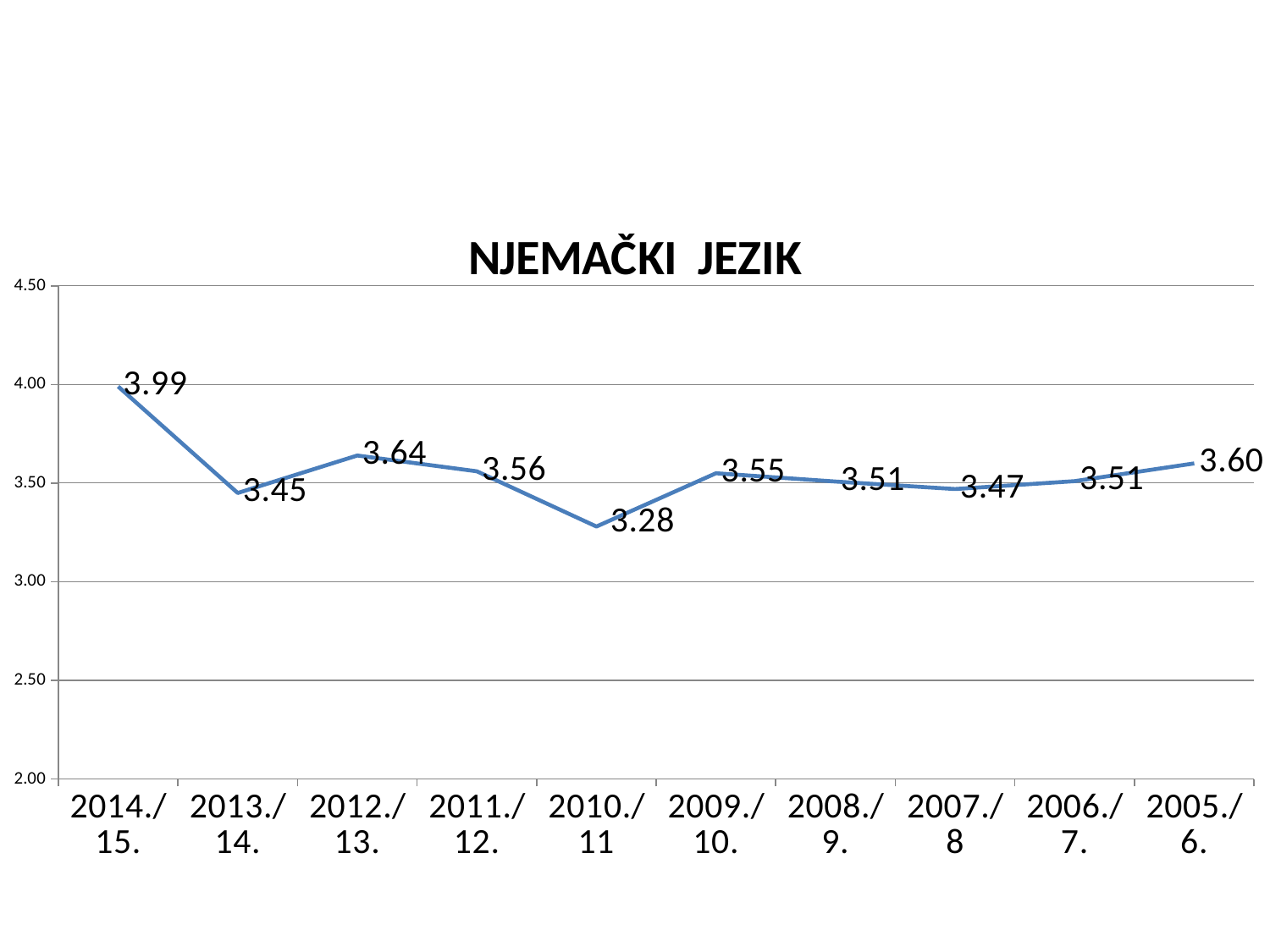
What is the value for 2007./8? 3.47 Which school year has the lowest value? 2010./11 Which school year has the highest value? 2014./15. What kind of chart is shown? line chart What is the difference between the values for 2014./15. and 2013./14.? 0.54 How many school years are plotted on the chart? 10 What is the title of the chart? NJEMAČKI JEZIK Is the value for 2010./11 greater or less than 3.50? less What is the value for 2014./15.? 3.99 What is the value for 2010./11? 3.28 Which is larger, the value for 2012./13. or the value for 2011./12.? 2012./13. What is the value for 2005./6.? 3.60